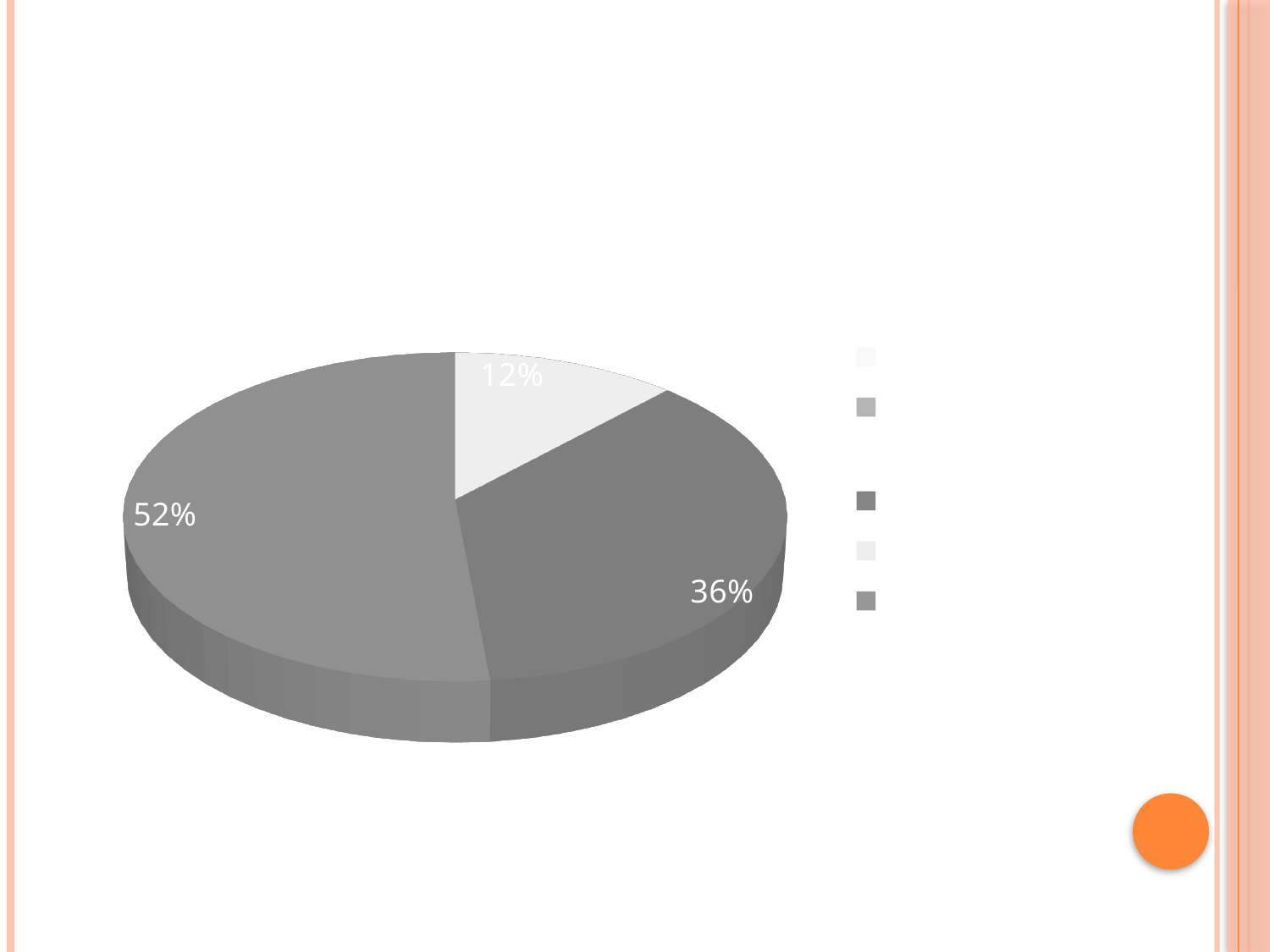
Does the largest slice of the pie chart account for more or less than half of the pie? More Which is larger, the slice labelled 36% or the slice labelled 12%? The 36% slice What is the largest percentage shown on the pie chart? 52% What kind of chart is shown on the slide? Pie chart What is the difference between the 52% slice and the 36% slice? 16 percentage points How many slices are labelled with a percentage on the pie chart? 3 What colour is the 12% slice of the pie chart? Light grey What do the three labelled slices of the pie chart add up to? 100% Is the pie chart drawn in 3D or flat? 3D How many entries does the legend of the pie chart list? 5 What is the difference between the largest and smallest slices of the pie chart? 40 percentage points What is the smallest percentage shown on the pie chart? 12%